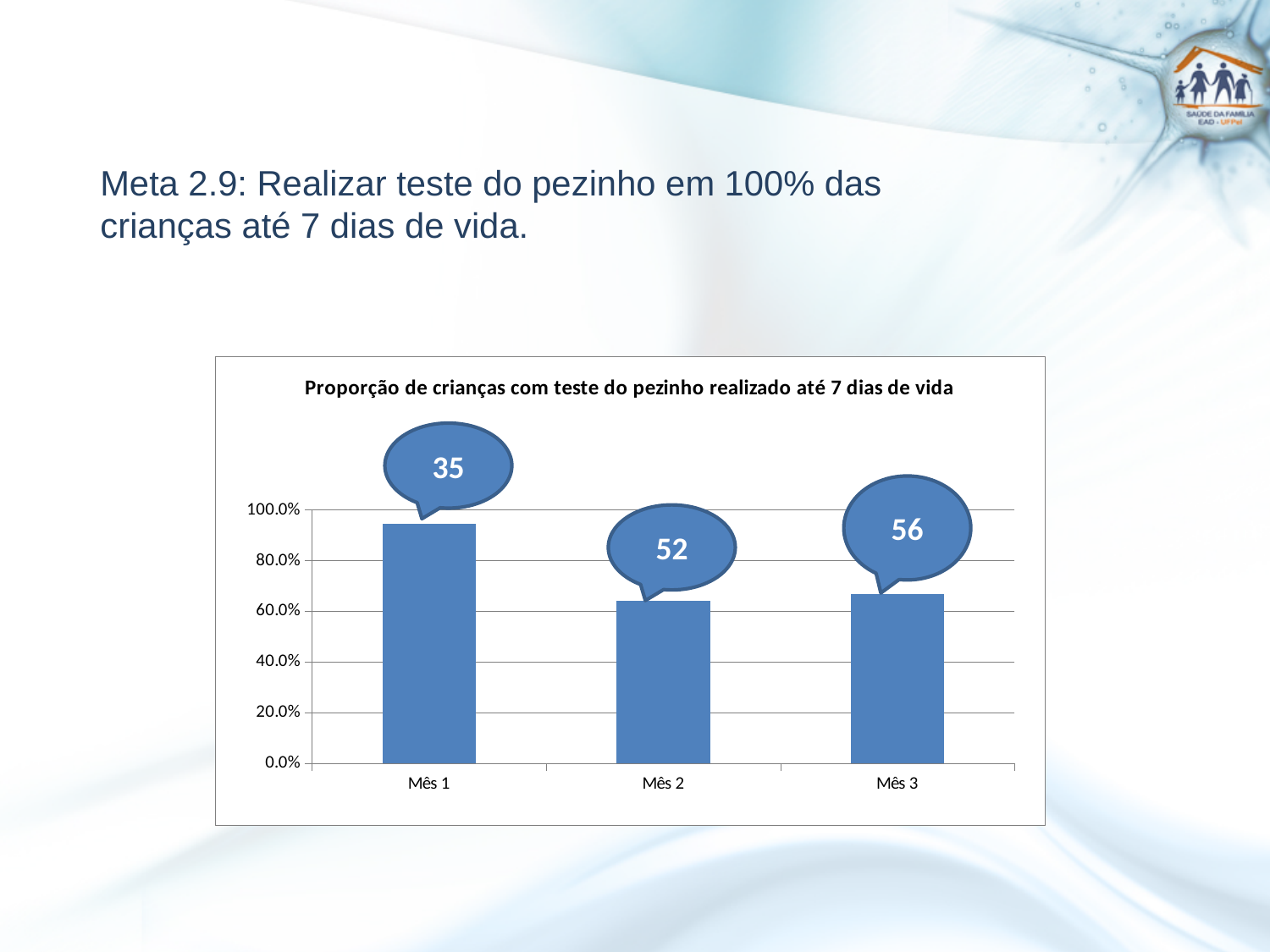
How many months (categories) are plotted on the x axis? 3 Is the value for Mês 2 greater or less than 80.0%? less Does the proportion rise or fall from Mês 1 to Mês 2? fall What number is shown in the callout above the Mês 3 bar? 56 Is the value for Mês 1 greater or less than 100.0%? less Which month has the highest proportion of children with the heel-prick test done within 7 days? Mês 1 What kind of chart is shown on the slide? bar chart Is the value for Mês 2 greater or less than 60.0%? greater What number is shown in the callout above the Mês 1 bar? 35 Which is larger, the value for Mês 1 or the value for Mês 2? Mês 1